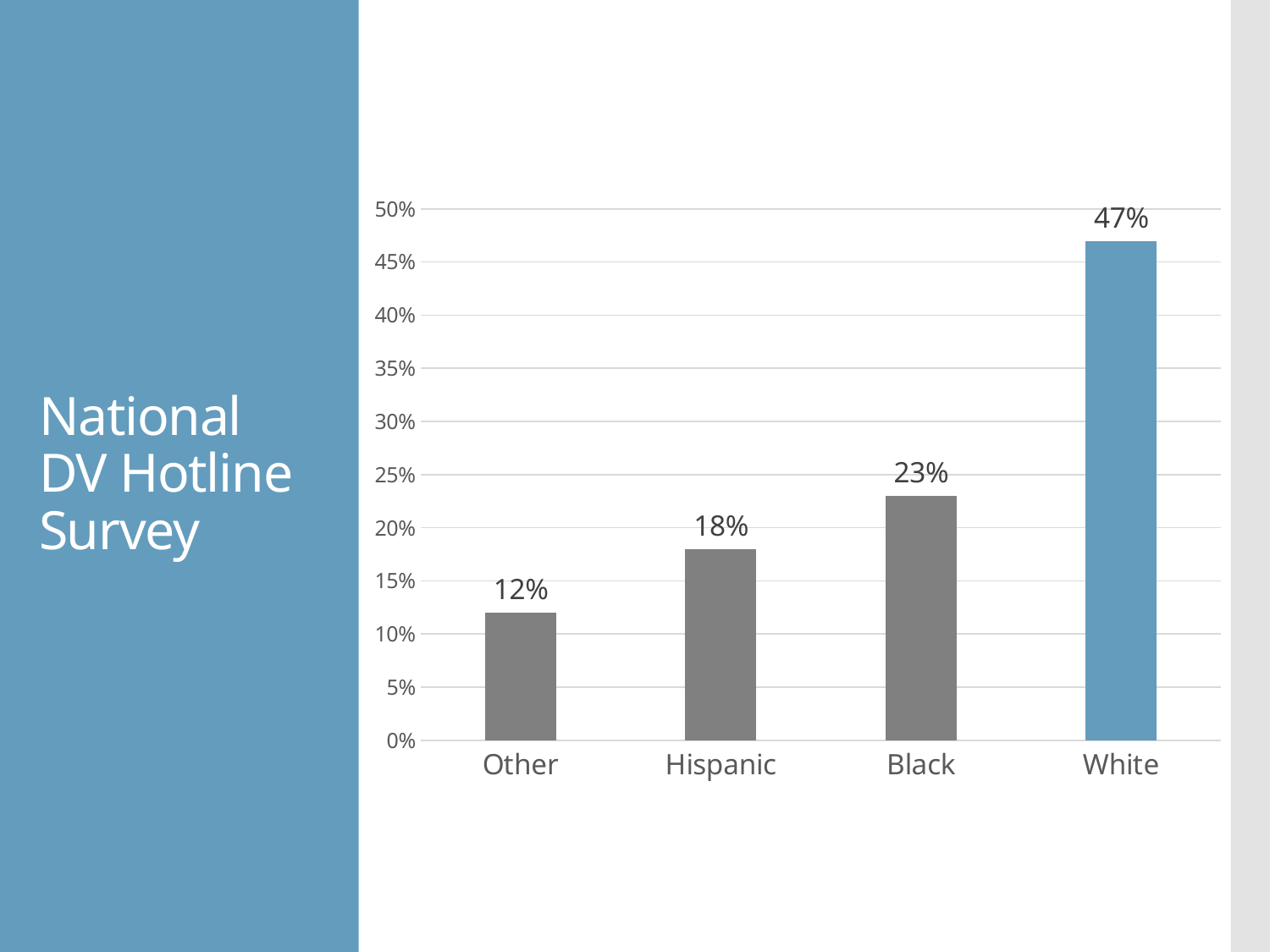
Which is larger, the value for Black or the value for Hispanic? Black What kind of chart is shown on the slide? bar chart How many categories are shown on the x axis? 4 Which category has the lowest value? Other What is the value for Hispanic? 18% What is the value for White? 47% What is the difference between the values for Black and Hispanic? 5% What is the difference between the values for White and Black? 24% What is the value for Other? 12% Which category has the highest value? White Which bar is coloured blue rather than grey? White Is the value for Black greater or less than 20%? greater